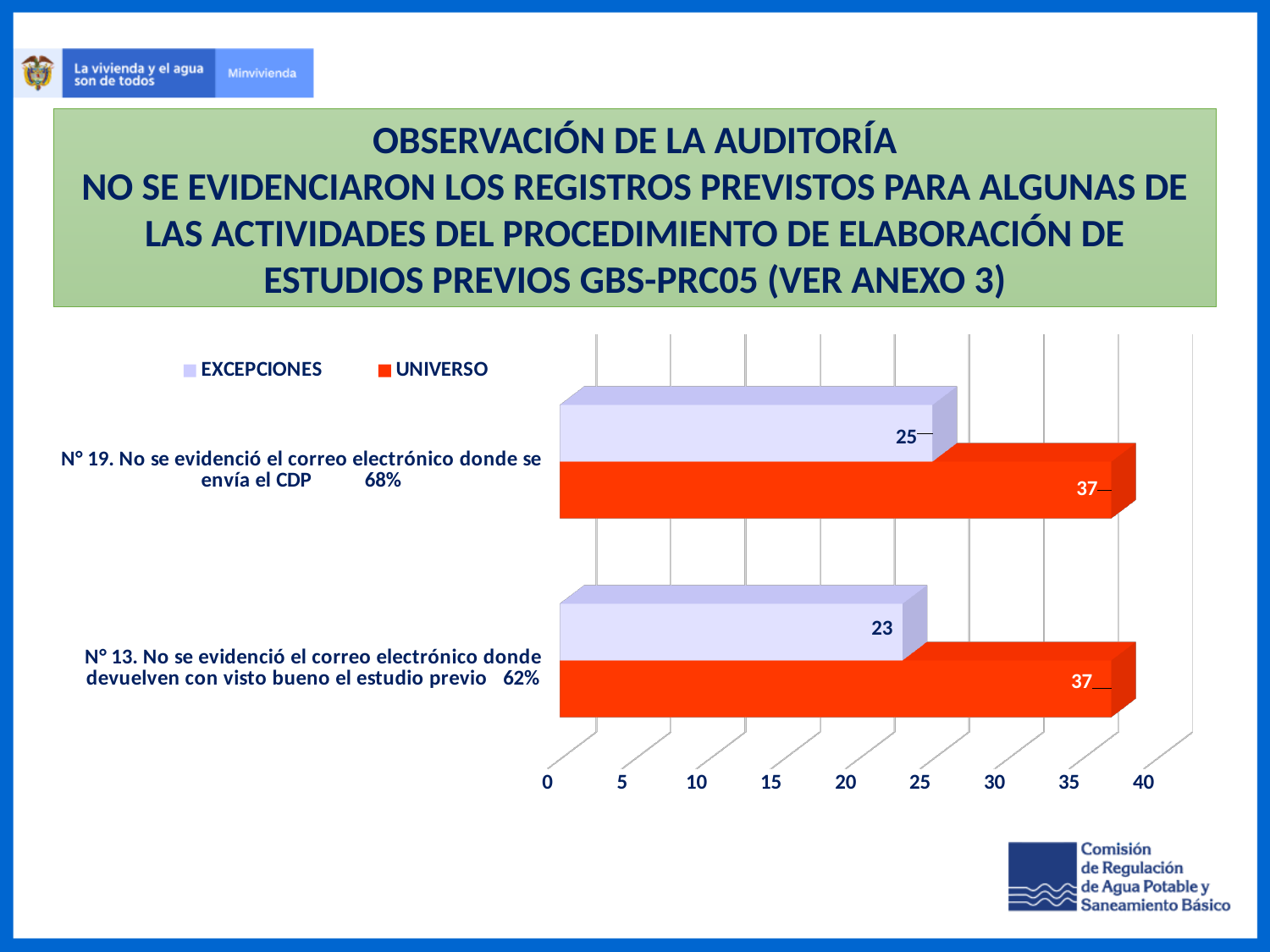
What is the UNIVERSO value for category N° 13 (No se evidenció el correo electrónico donde devuelven con visto bueno el estudio previo)? 37 How many series does the legend list? 2 Which category has the higher EXCEPCIONES value? N° 19. No se evidenció el correo electrónico donde se envía el CDP What is the difference between the UNIVERSO and EXCEPCIONES values for category N° 13? 14 What is the UNIVERSO value for category N° 19? 37 What is the difference between the UNIVERSO and EXCEPCIONES values for category N° 19? 12 What colour are the UNIVERSO bars in the chart? Red For category N° 13, which series has the larger value, EXCEPCIONES or UNIVERSO? UNIVERSO What kind of chart is shown on the slide? Bar chart What is the EXCEPCIONES value for category N° 19 (No se evidenció el correo electrónico donde se envía el CDP)? 25 What is the EXCEPCIONES value for category N° 13? 23 How many categories are shown in the chart? 2